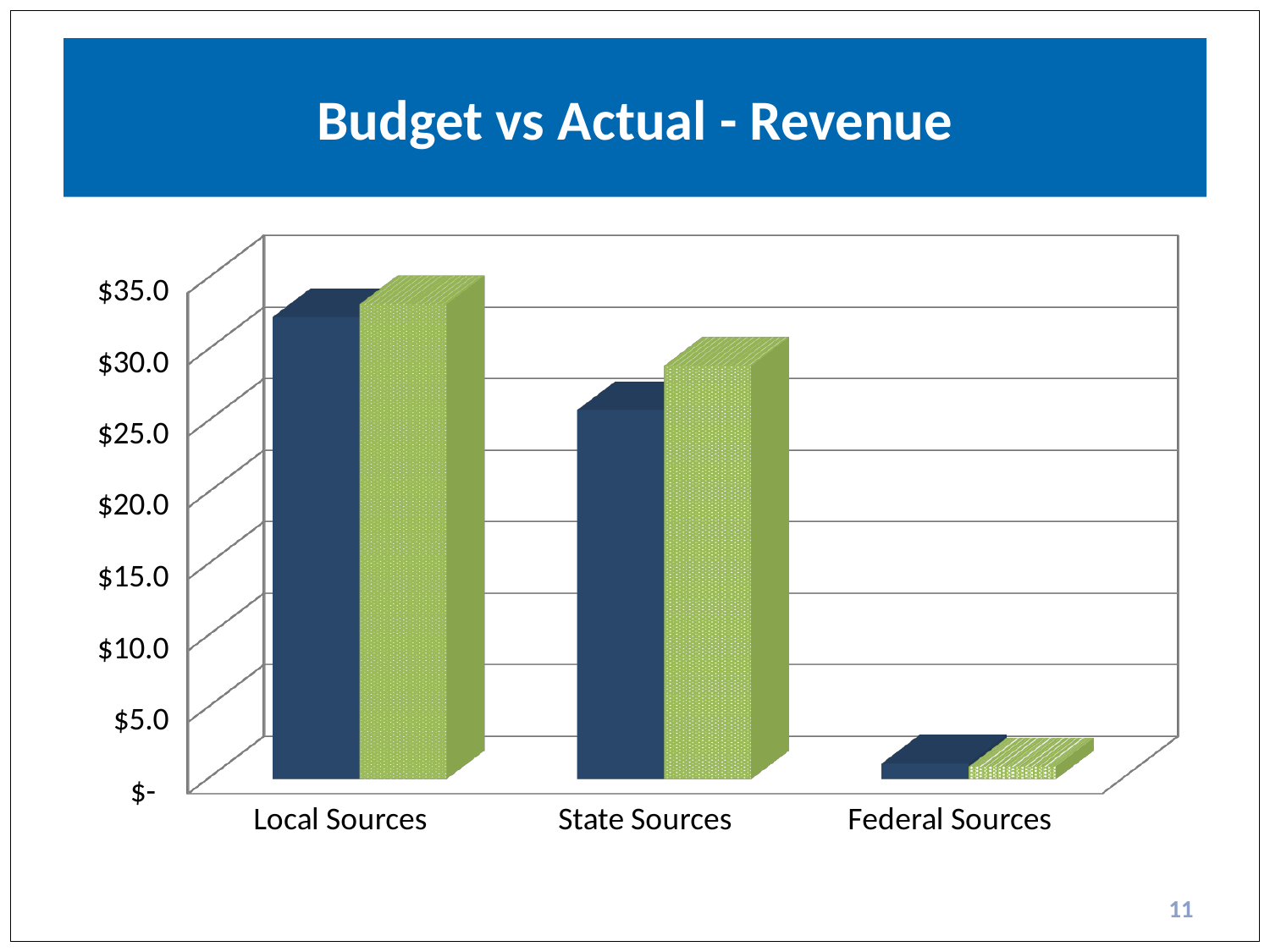
What is the title of the chart? Budget vs Actual - Revenue Is the dark blue bar for State Sources greater or less than $30.0? less Which category has the lowest values in the chart? Federal Sources Do the values rise or fall moving from Local Sources to Federal Sources along the x axis? Fall Is the green bar for Federal Sources greater or less than $5.0? less Which category has the highest values in the chart? Local Sources Is the dark blue bar for Local Sources greater or less than $30.0? greater How many categories are shown on the x axis of the chart? 3 What kind of chart is shown on the slide? Bar chart How many bars are plotted for each category in the chart? 2 Which is larger, the dark blue bar for Local Sources or the dark blue bar for State Sources? Local Sources